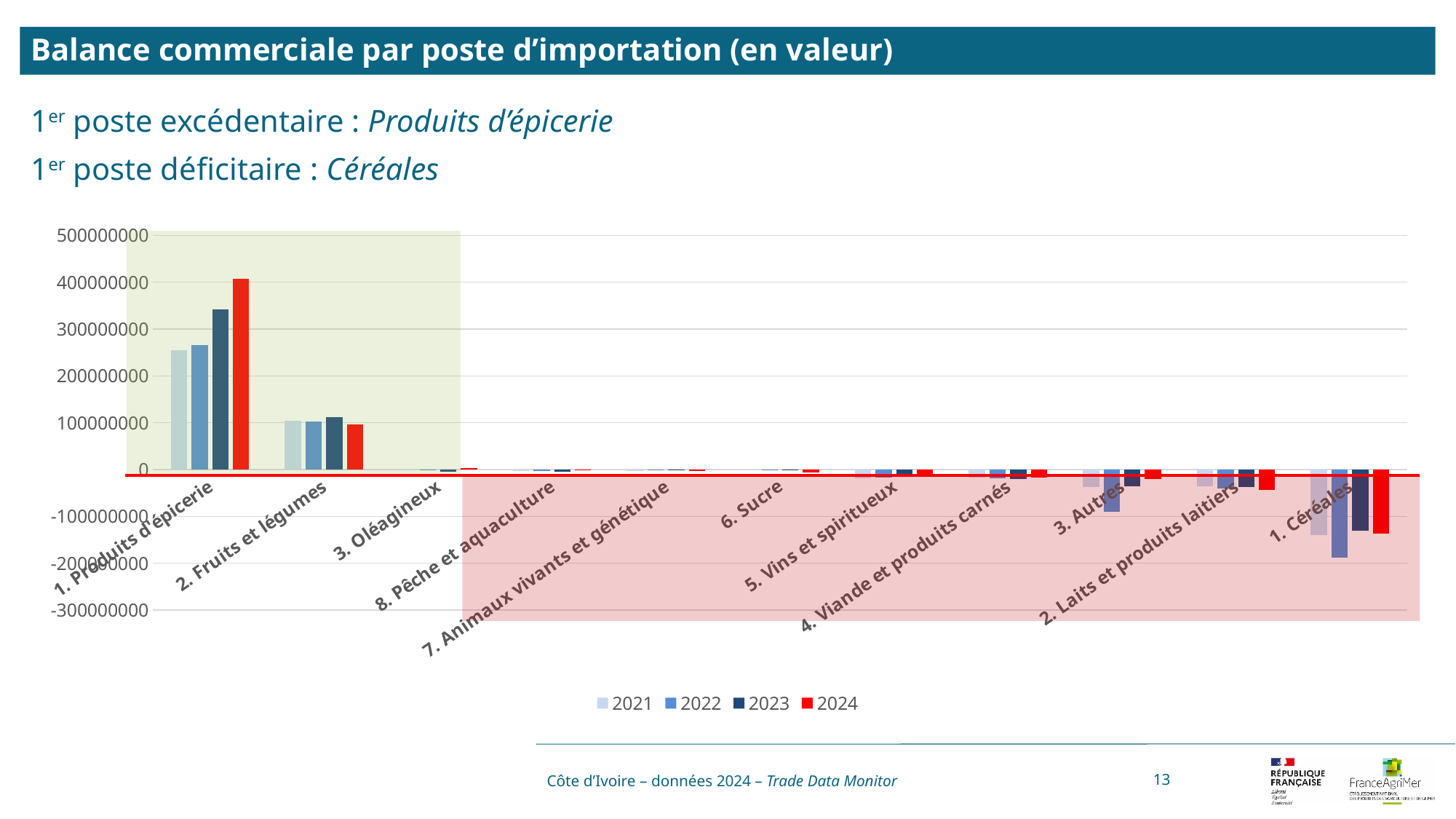
For 1. Produits d'épicerie, which is larger: the 2023 value or the 2024 value? 2024 Is the 2024 value for 1. Produits d'épicerie greater or less than 300000000? greater What colour represents the 2024 series in the legend? red Is the 2021 value for 1. Produits d'épicerie greater or less than 200000000? greater What kind of chart is shown on the slide? bar chart Is the 2022 value for 1. Céréales greater or less than -100000000? less Which category has the lowest value for 2024? 1. Céréales How many series does the legend list? 4 Which category has the highest value for 2024? 1. Produits d'épicerie How many categories are shown on the x axis? 11 Do the values for 1. Produits d'épicerie rise or fall from 2021 to 2024? rise